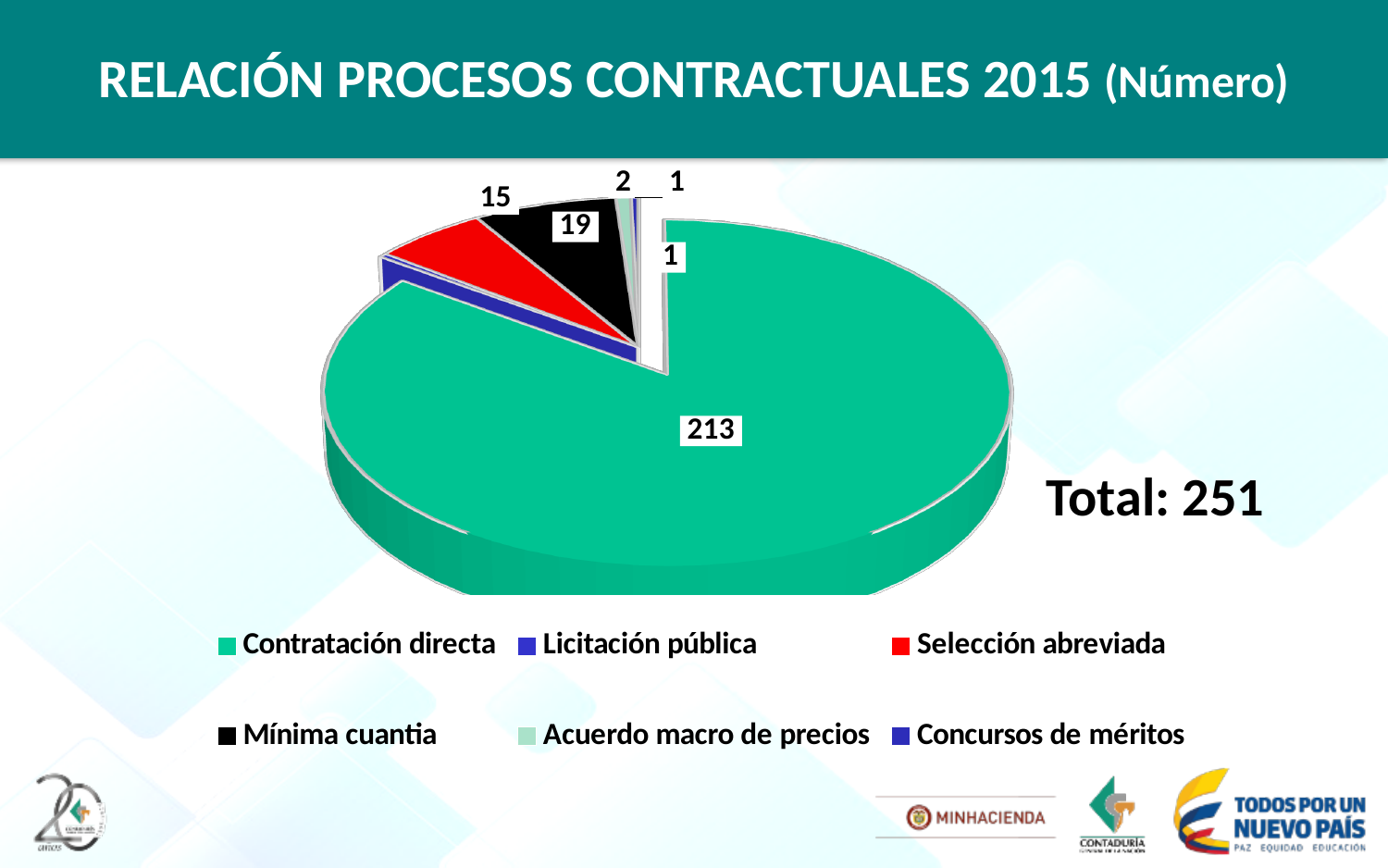
What kind of chart is shown on the slide? Pie chart What is the value for Acuerdo macro de precios? 2 What is the value for Mínima cuantía? 19 Which is larger, the value for Selección abreviada or the value for Mínima cuantía? Mínima cuantía Which category has the largest slice of the pie? Contratación directa What is the value for Licitación pública? 1 How many categories does the legend list? 6 What total is shown on the slide for all contractual processes? 251 What is the value for Selección abreviada? 15 What is the value for Contratación directa? 213 What is the difference between the values for Mínima cuantía and Selección abreviada? 4 What is the difference between the values for Contratación directa and Mínima cuantía? 194